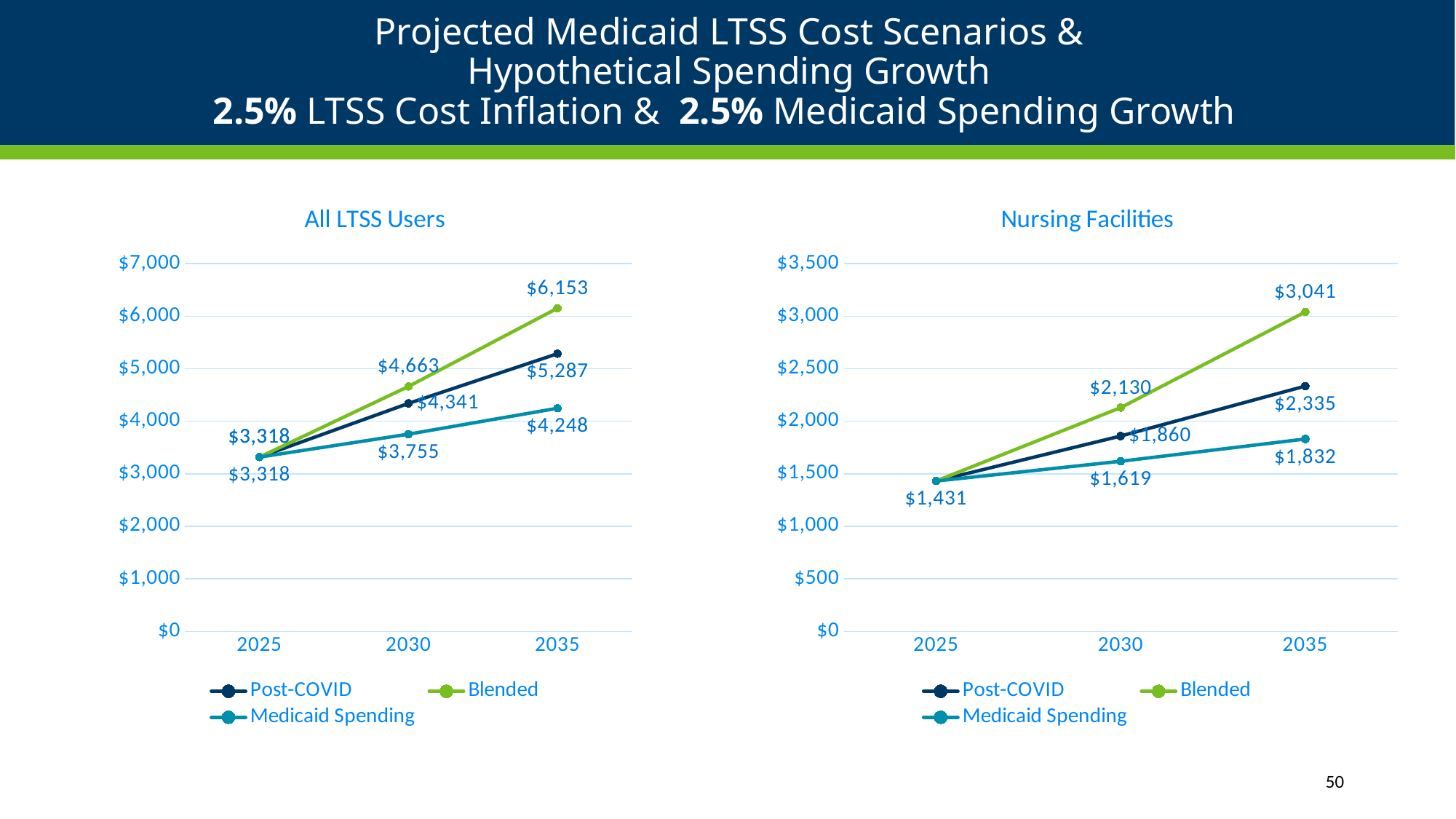
In the Nursing Facilities chart, what is the value shown for 2025? $1,431 In the All LTSS Users chart, which is larger in 2030: Post-COVID or Medicaid Spending? Post-COVID In the All LTSS Users chart, which series has the lowest value in 2035? Medicaid Spending How many series does the legend of the Nursing Facilities chart list? 3 In the Nursing Facilities chart, what is the difference between the Blended and Medicaid Spending values in 2030? $511 In the Nursing Facilities chart, which series has the highest value in 2035? Blended In the Nursing Facilities chart, what is the Post-COVID value for 2035? $2,335 In the All LTSS Users chart, what is the Blended value for 2035? $6,153 In the All LTSS Users chart, what is the difference between the Blended and Post-COVID values in 2035? $866 In the Nursing Facilities chart, does the Blended series rise or fall from 2025 to 2035? Rise What kind of chart is the All LTSS Users chart? Line chart In the All LTSS Users chart, what is the Medicaid Spending value for 2030? $3,755